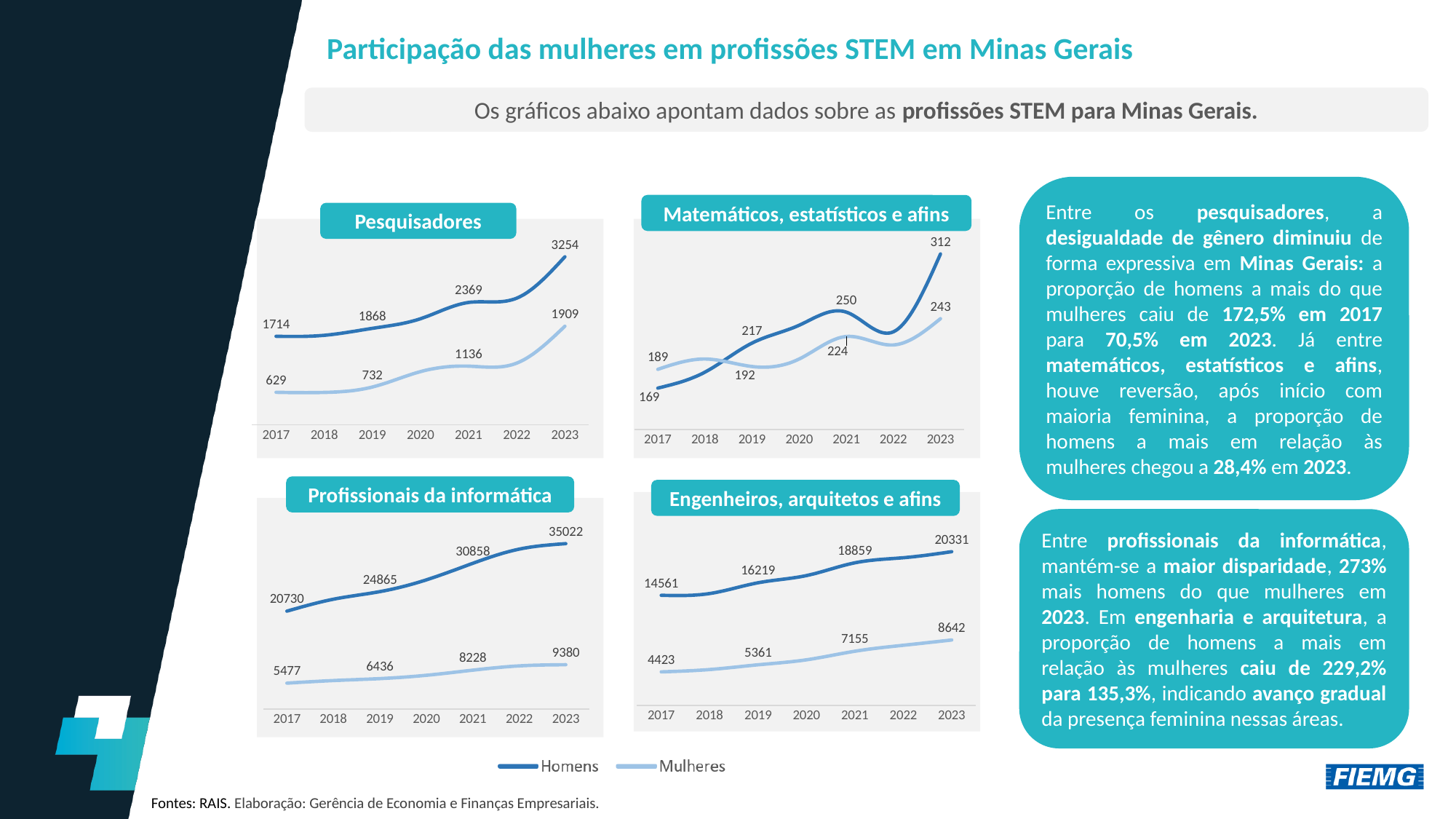
In the 'Pesquisadores' chart, what is the value for Mulheres in 2017? 629 In the 'Matemáticos, estatísticos e afins' chart, which series has the higher value in 2017, Homens or Mulheres? Mulheres In the 'Matemáticos, estatísticos e afins' chart, what is the value for Mulheres in 2021? 224 In the 'Pesquisadores' chart, in which labelled year is the Mulheres value lowest? 2017 How many years are shown on the x axis of the 'Profissionais da informática' chart? 7 In the 'Profissionais da informática' chart, does the Homens series rise or fall from 2017 to 2023? Rise In the 'Pesquisadores' chart, what is the value for Homens in 2023? 3254 What type of chart is used for 'Pesquisadores'? Line chart In the 'Engenheiros, arquitetos e afins' chart, what is the value for Mulheres in 2019? 5361 In the 'Engenheiros, arquitetos e afins' chart, what is the difference between the Homens values in 2023 and 2017? 5770 In the 'Profissionais da informática' chart, what is the difference between Homens and Mulheres in 2023? 25642 How many series does the shared legend list? 2